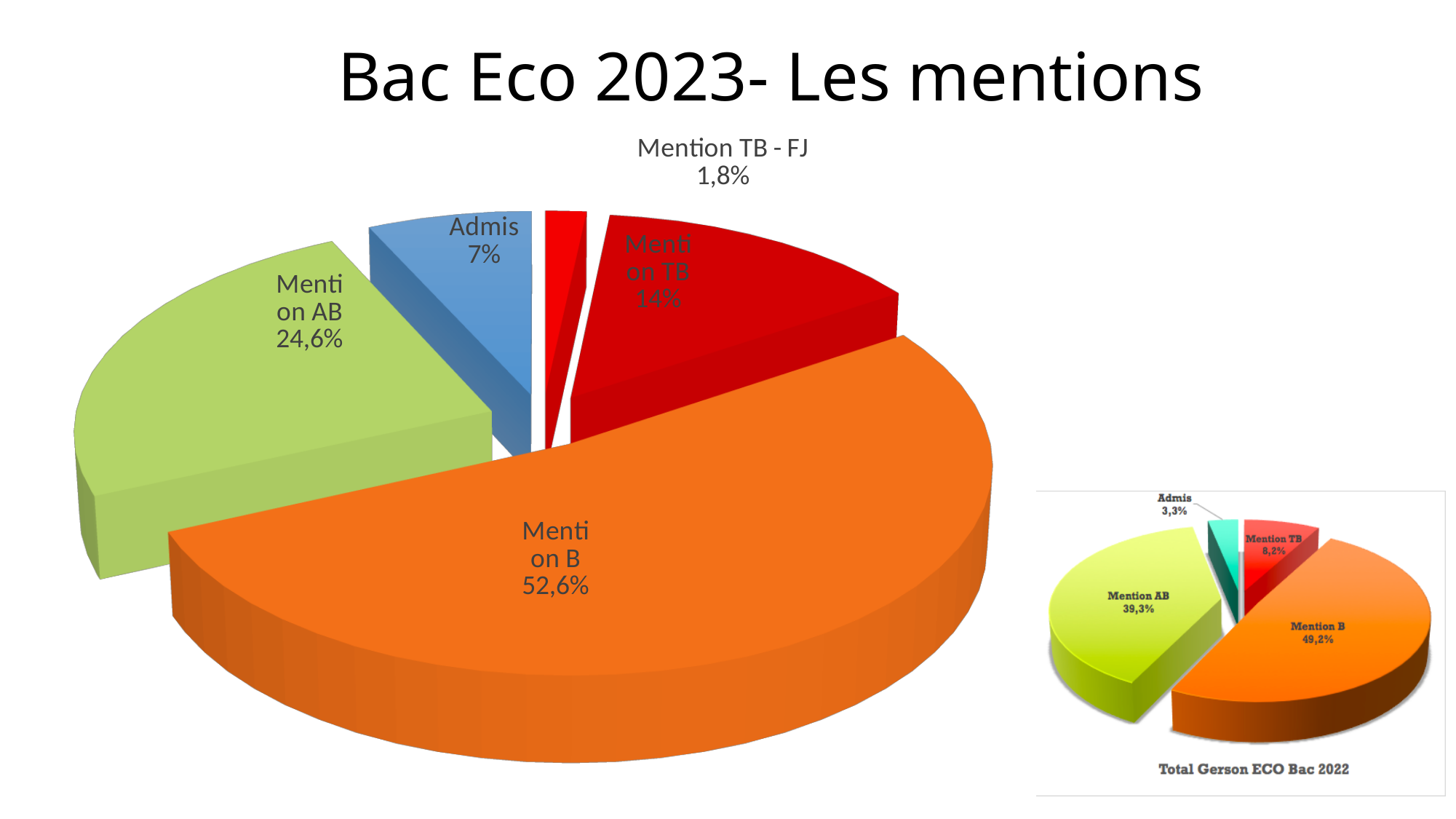
In the small inset chart titled 'Total Gerson ECO Bac 2022', what is the value for Mention AB? 39,3% In the large 2023 pie chart, what percentage is labelled for Admis? 7% In the large 2023 pie chart, which category has the largest slice? Mention B In the large 2023 pie chart, what is the value for Mention TB - FJ? 1,8% In the large 2023 pie chart, what is the value for Mention AB? 24,6% In the large 2023 pie chart, which is larger, Mention AB or Mention TB? Mention AB In the large 2023 pie chart, what share does Mention B have? 52,6% In the small inset chart titled 'Total Gerson ECO Bac 2022', what is the value for Admis? 3,3% What kind of chart is the large chart on the slide? Pie chart In the large 2023 pie chart, which category has the smallest slice? Mention TB - FJ In the large 2023 pie chart, how many slices are there? 5 In the small inset chart titled 'Total Gerson ECO Bac 2022', which category has the largest slice? Mention B